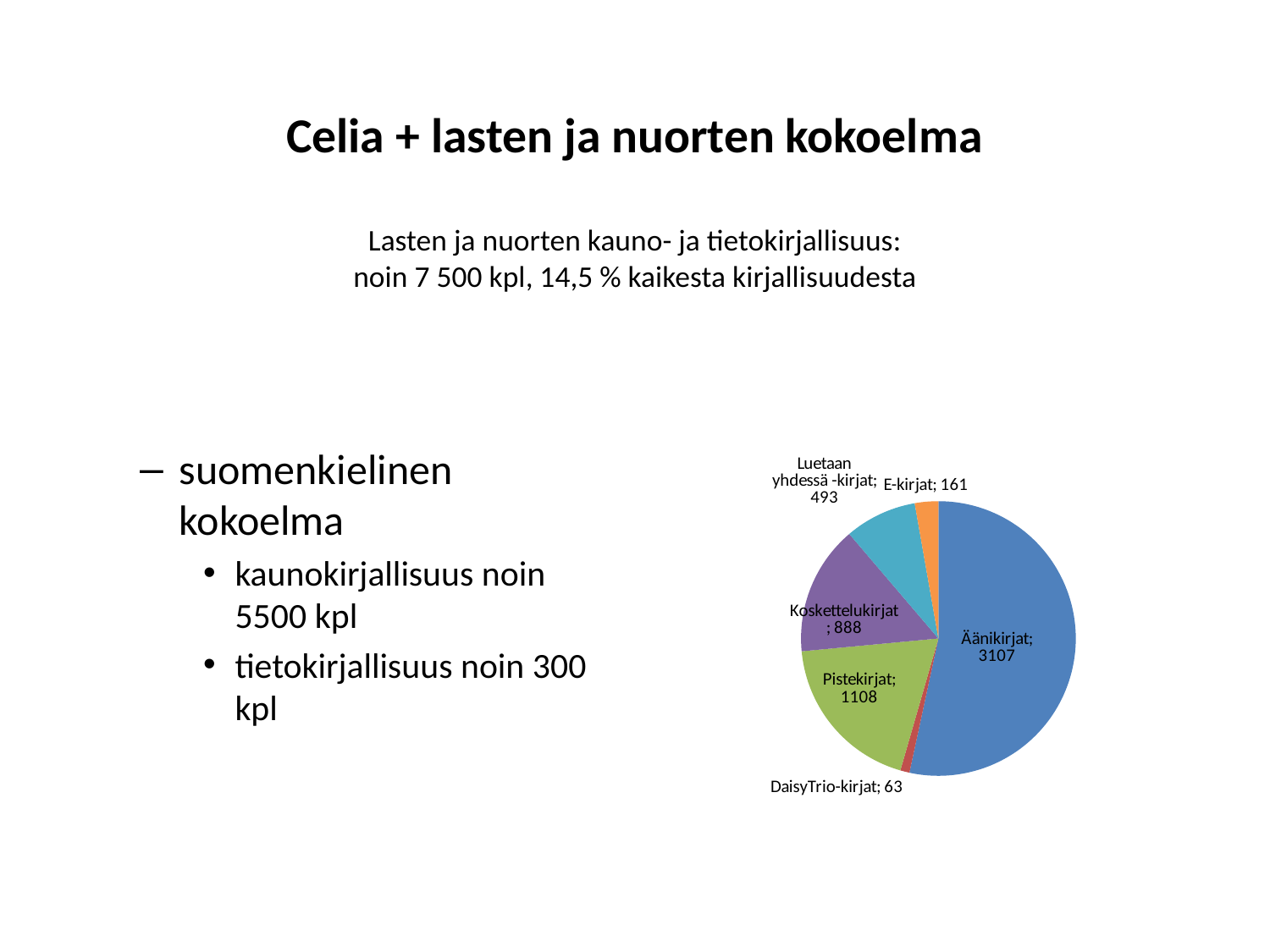
What is the value for Koskettelukirjat in the pie chart? 888 Which category has the smallest slice in the pie chart? DaisyTrio-kirjat How many slices does the pie chart have? 6 What is the difference between the values for Luetaan yhdessä -kirjat and E-kirjat? 332 What is the difference between the values for Äänikirjat and Pistekirjat? 1999 What is the value for Pistekirjat in the pie chart? 1108 What is the value for Äänikirjat in the pie chart? 3107 Which is larger in the pie chart, Pistekirjat or Koskettelukirjat? Pistekirjat What type of chart is shown on the slide? pie chart What is the total of all the values shown in the pie chart? 5820 What is the value for DaisyTrio-kirjat in the pie chart? 63 Which category has the largest slice in the pie chart? Äänikirjat